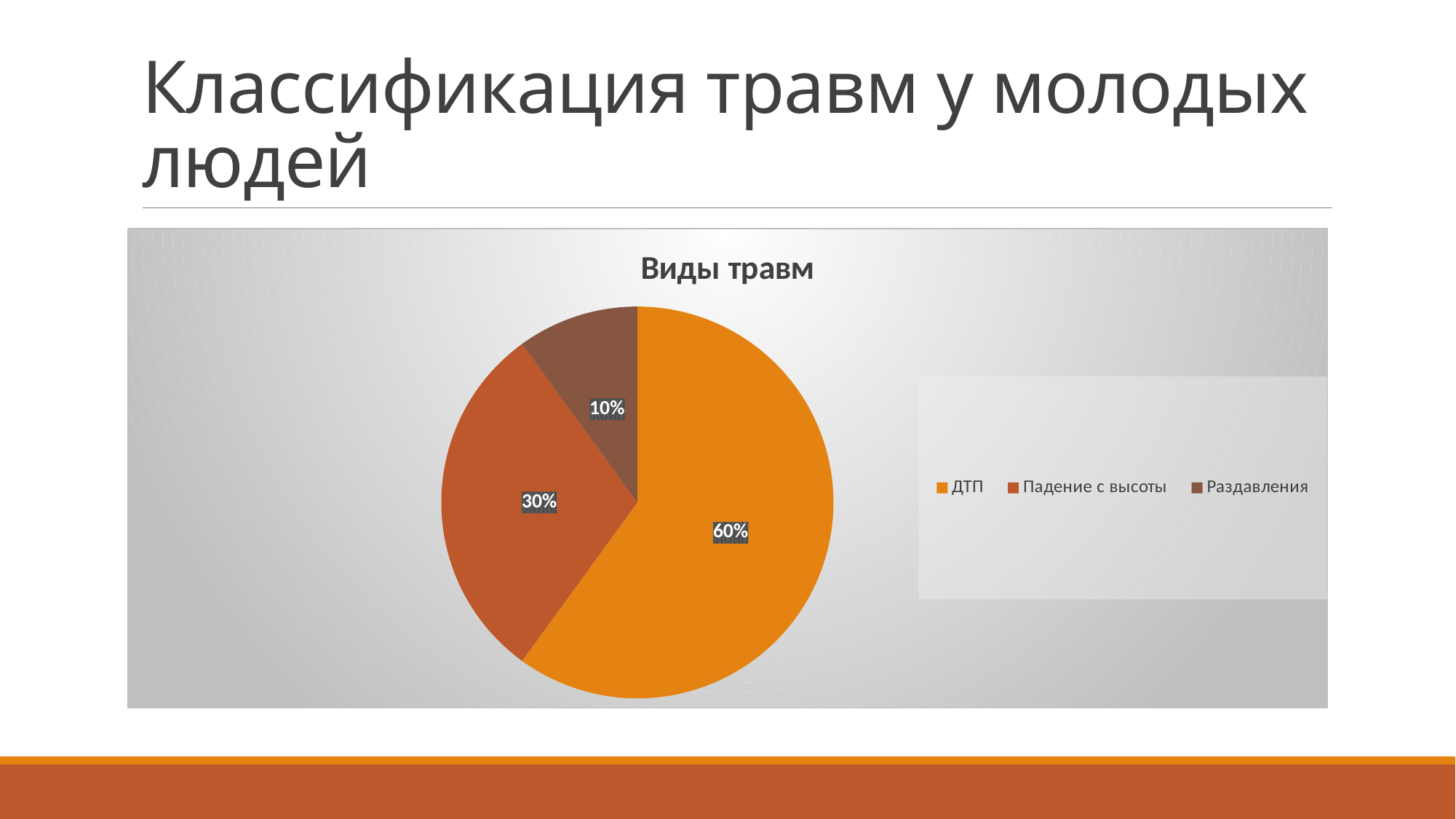
Which is larger, the slice for Падение с высоты or the slice for Раздавления? Падение с высоты Which category has the largest slice of the pie? ДТП What is the title of the chart? Виды травм What kind of chart is shown on the slide? pie chart What share of the pie does Падение с высоты take? 30% What is the difference in percentage points between Падение с высоты and Раздавления? 20% What is the difference in percentage points between ДТП and Падение с высоты? 30% What share of the pie does ДТП take? 60% How many slices does the pie chart have? 3 How many entries does the legend list? 3 Which category has the smallest slice of the pie? Раздавления What share of the pie does Раздавления take? 10%